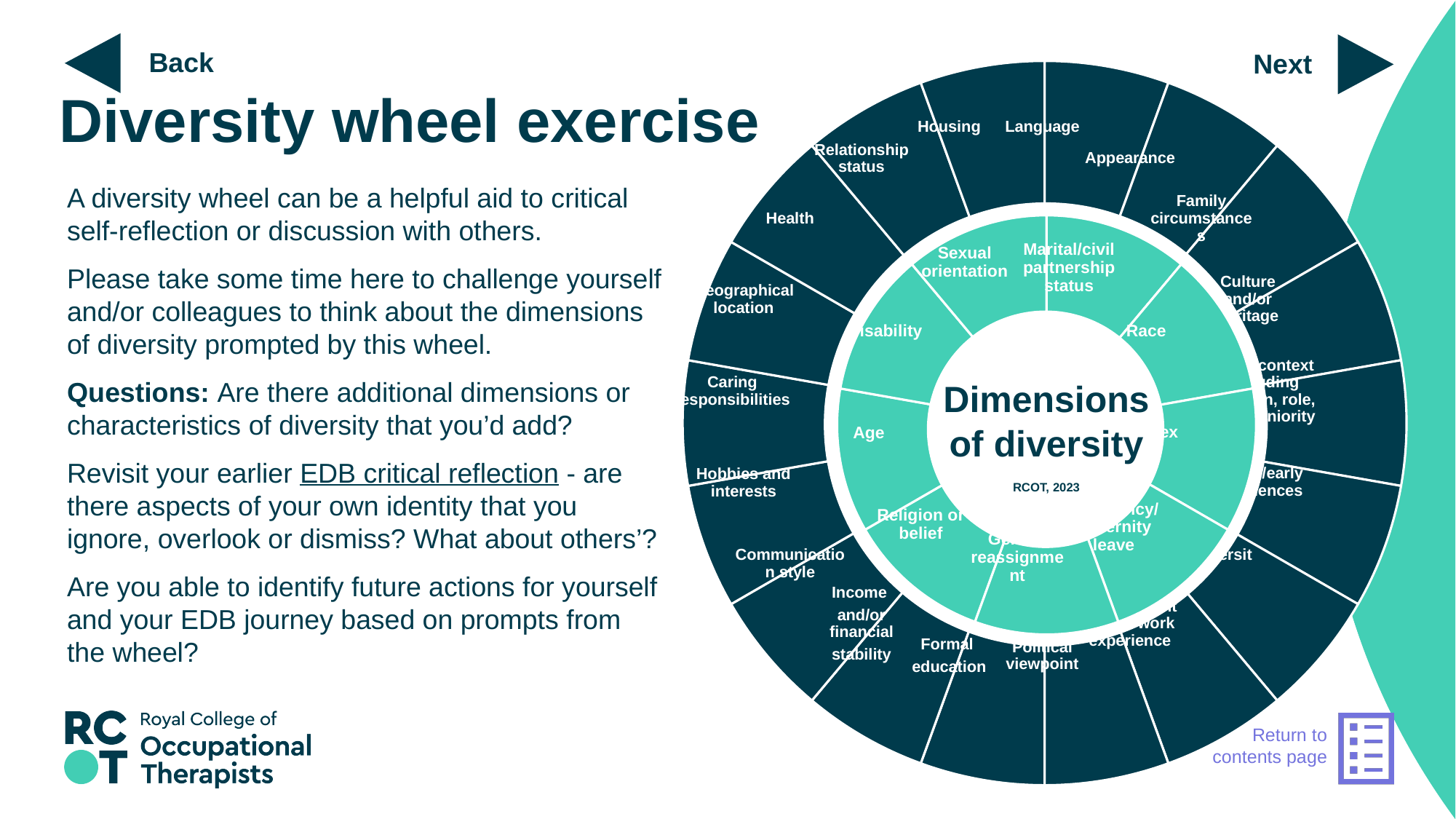
How many segments are in the outer (dark) ring of the diversity wheel? 18 How many segments are in the inner (green) ring of the diversity wheel? 9 What text appears in the centre of the diversity wheel? Dimensions of diversity Which ring of the diversity wheel contains the segment labelled 'Housing', the inner or the outer ring? outer Which ring of the diversity wheel contains the segment labelled 'Age', the inner or the outer ring? inner What source and year are printed beneath the centre title of the wheel? RCOT, 2023